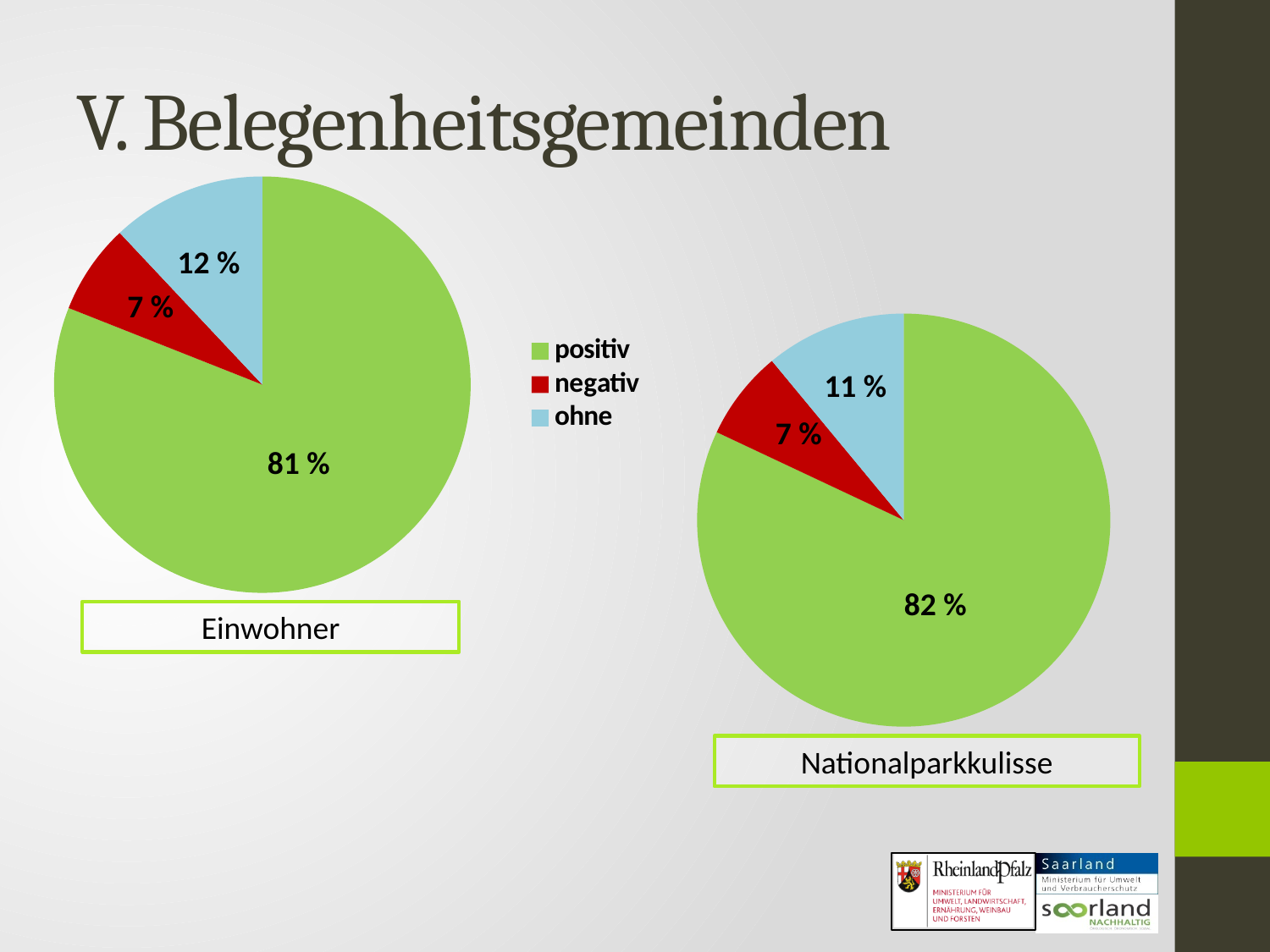
In the Nationalparkkulisse pie chart, which category has the smallest slice? negativ In the Nationalparkkulisse pie chart, is the ohne slice larger or smaller than the negativ slice? larger How many slices does the Einwohner pie chart have? 3 In the Nationalparkkulisse pie chart, what share is labelled for the negativ slice? 7 % In the Einwohner pie chart, what is the difference between the ohne share and the negativ share? 5 % What type of chart is used for Nationalparkkulisse? pie chart In the Einwohner pie chart, what share is labelled for the ohne slice? 12 % How many entries does the legend list? 3 Is the positiv share larger in the Einwohner pie chart or in the Nationalparkkulisse pie chart? Nationalparkkulisse In the Nationalparkkulisse pie chart, what share is labelled for the positiv slice? 82 % In the Einwohner pie chart, what share is labelled for the positiv slice? 81 % In the Einwohner pie chart, which category has the largest slice? positiv